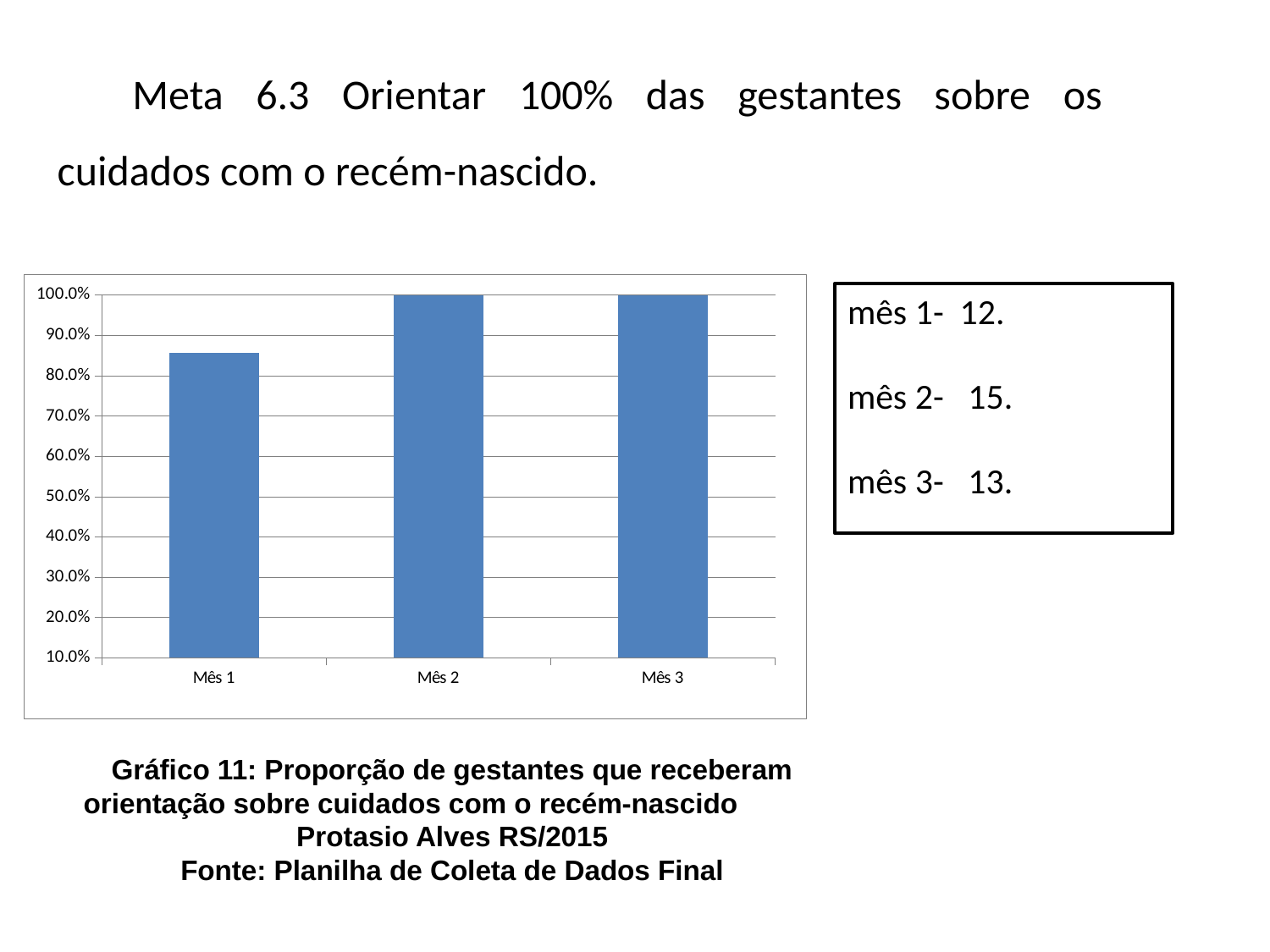
Does the value rise or fall from Mês 1 to Mês 2? rise What is the value for Mês 3 on the chart? 100.0% What is the highest value shown on the vertical axis of the chart? 100.0% Is the value for Mês 1 greater or less than 90.0%? less How many categories (months) are plotted on the chart? 3 Which month has the lowest value on the chart? Mês 1 What is the value for Mês 2 on the chart? 100.0% What is the number of the graph given in the caption below the chart? Gráfico 11 What kind of chart is shown on the slide? bar chart Is the value for Mês 1 greater or less than 80.0%? greater Which is larger, the value for Mês 1 or the value for Mês 2? Mês 2